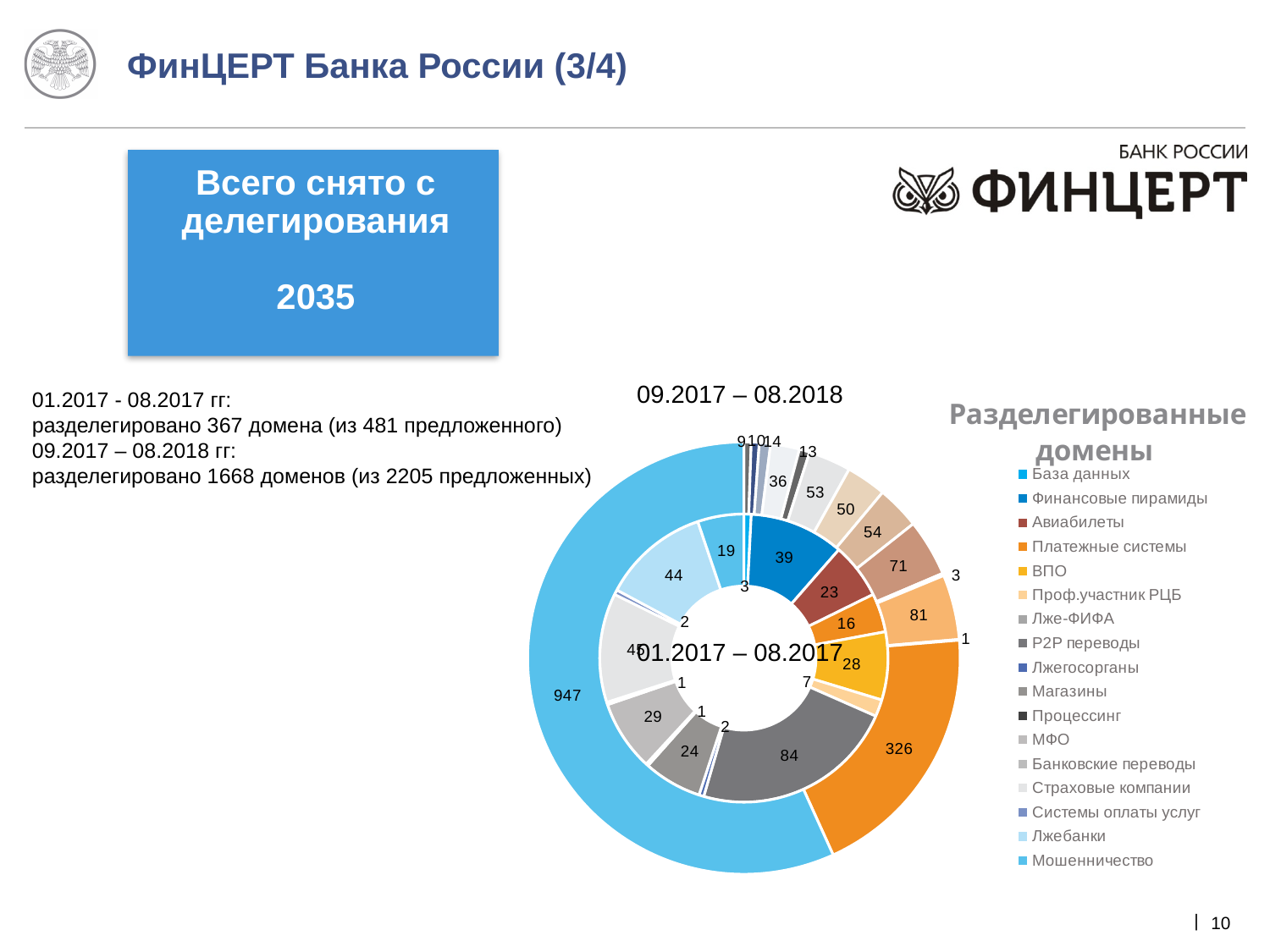
What is the value for База данных in the inner ring (01.2017 – 08.2017)? 3 What kind of chart is shown on the slide? Doughnut (pie) chart What is the value for ВПО in the inner ring (01.2017 – 08.2017)? 28 What is the largest value in the inner ring (01.2017 – 08.2017) of the chart? 84 Which period does the outer ring of the doughnut chart represent? 09.2017 – 08.2018 What is the largest value in the outer ring (09.2017 – 08.2018) of the chart? 947 What is the value for Мошенничество in the outer ring (09.2017 – 08.2018)? 947 How many categories does the chart legend list? 17 What is the value for Платежные системы in the outer ring (09.2017 – 08.2018)? 14 In the outer ring, which is larger: the value for Мошенничество or the value for Платежные системы? Мошенничество What is the title of the chart on the slide? Разделегированные домены